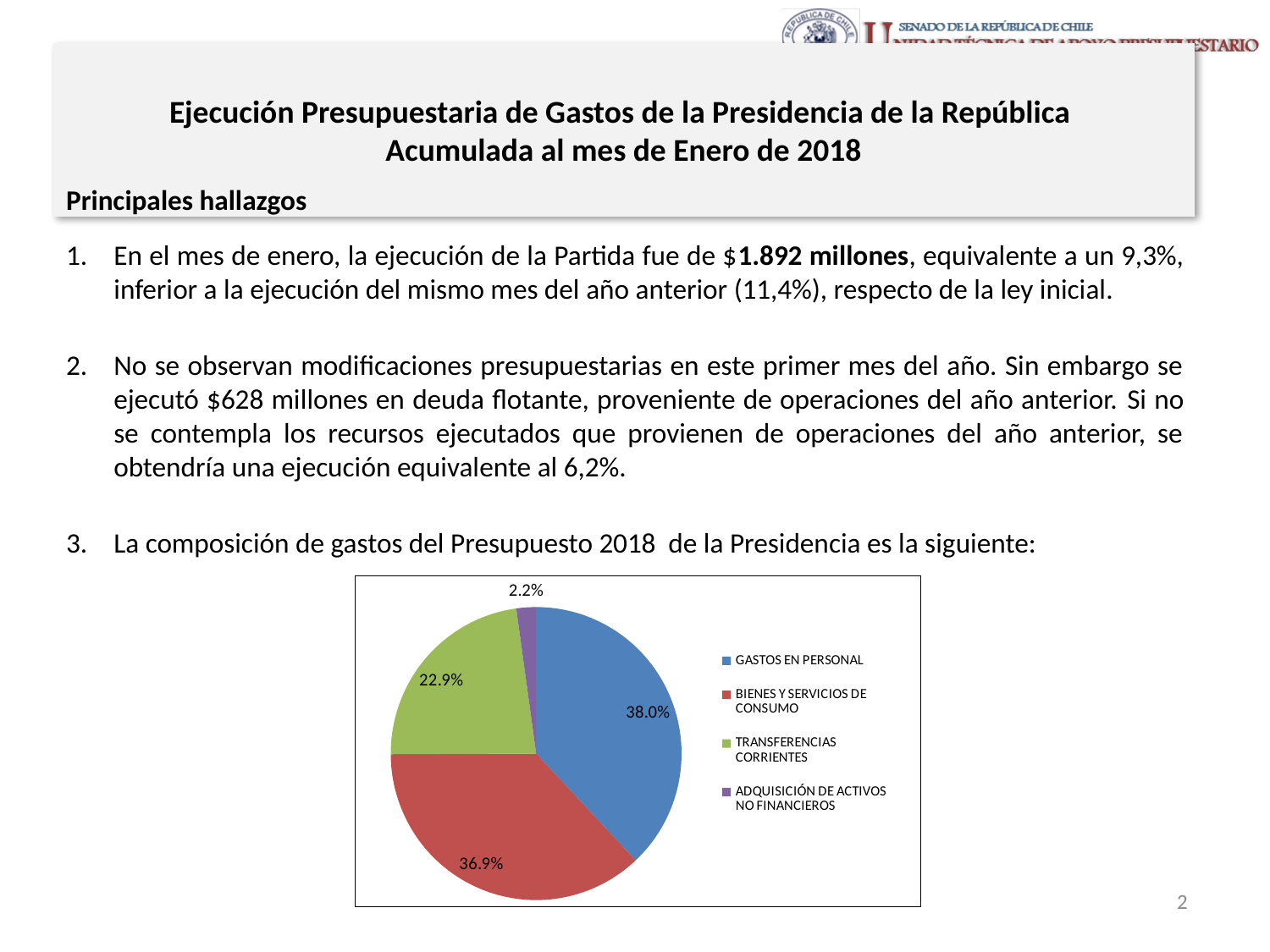
What share of the pie does GASTOS EN PERSONAL represent? 38.0% Which category has the smallest slice of the pie? ADQUISICIÓN DE ACTIVOS NO FINANCIEROS Which is larger, the slice for TRANSFERENCIAS CORRIENTES or the slice for ADQUISICIÓN DE ACTIVOS NO FINANCIEROS? TRANSFERENCIAS CORRIENTES How many categories does the pie chart show? 4 What is the difference in percentage points between GASTOS EN PERSONAL and BIENES Y SERVICIOS DE CONSUMO? 1.1 What colour is the slice for TRANSFERENCIAS CORRIENTES? green Which category has the largest slice of the pie? GASTOS EN PERSONAL What share of the pie does TRANSFERENCIAS CORRIENTES represent? 22.9% What is the difference in percentage points between TRANSFERENCIAS CORRIENTES and ADQUISICIÓN DE ACTIVOS NO FINANCIEROS? 20.7 What share of the pie does ADQUISICIÓN DE ACTIVOS NO FINANCIEROS represent? 2.2% What share of the pie does BIENES Y SERVICIOS DE CONSUMO represent? 36.9% What kind of chart is shown on the slide? pie chart